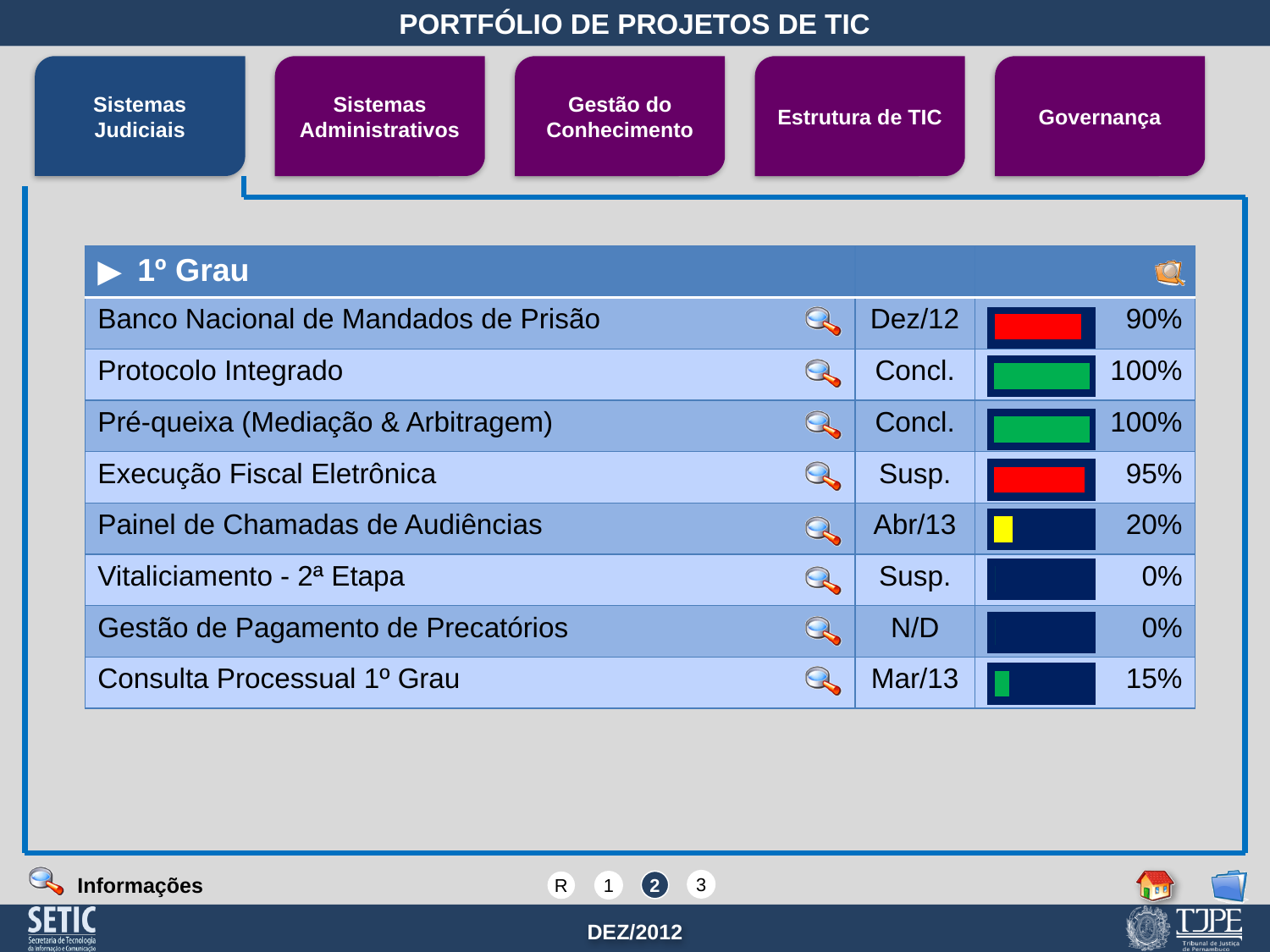
How many projects are listed under 1º Grau? 8 What colour is the progress bar for Protocolo Integrado? Green What is the completion percentage for Consulta Processual 1º Grau? 15% What is the difference in completion percentage between Execução Fiscal Eletrônica and Banco Nacional de Mandados de Prisão? 5% Which has a higher completion percentage, Painel de Chamadas de Audiências or Consulta Processual 1º Grau? Painel de Chamadas de Audiências What is the deadline shown for Painel de Chamadas de Audiências? Abr/13 What is the completion percentage for Banco Nacional de Mandados de Prisão? 90% Which projects have the highest completion percentage? Protocolo Integrado and Pré-queixa (Mediação & Arbitragem) What is the completion percentage for Painel de Chamadas de Audiências? 20% What is the completion percentage for Execução Fiscal Eletrônica? 95% Which projects have the lowest completion percentage? Vitaliciamento - 2ª Etapa and Gestão de Pagamento de Precatórios What kind of chart is used to show project progress? Bar chart